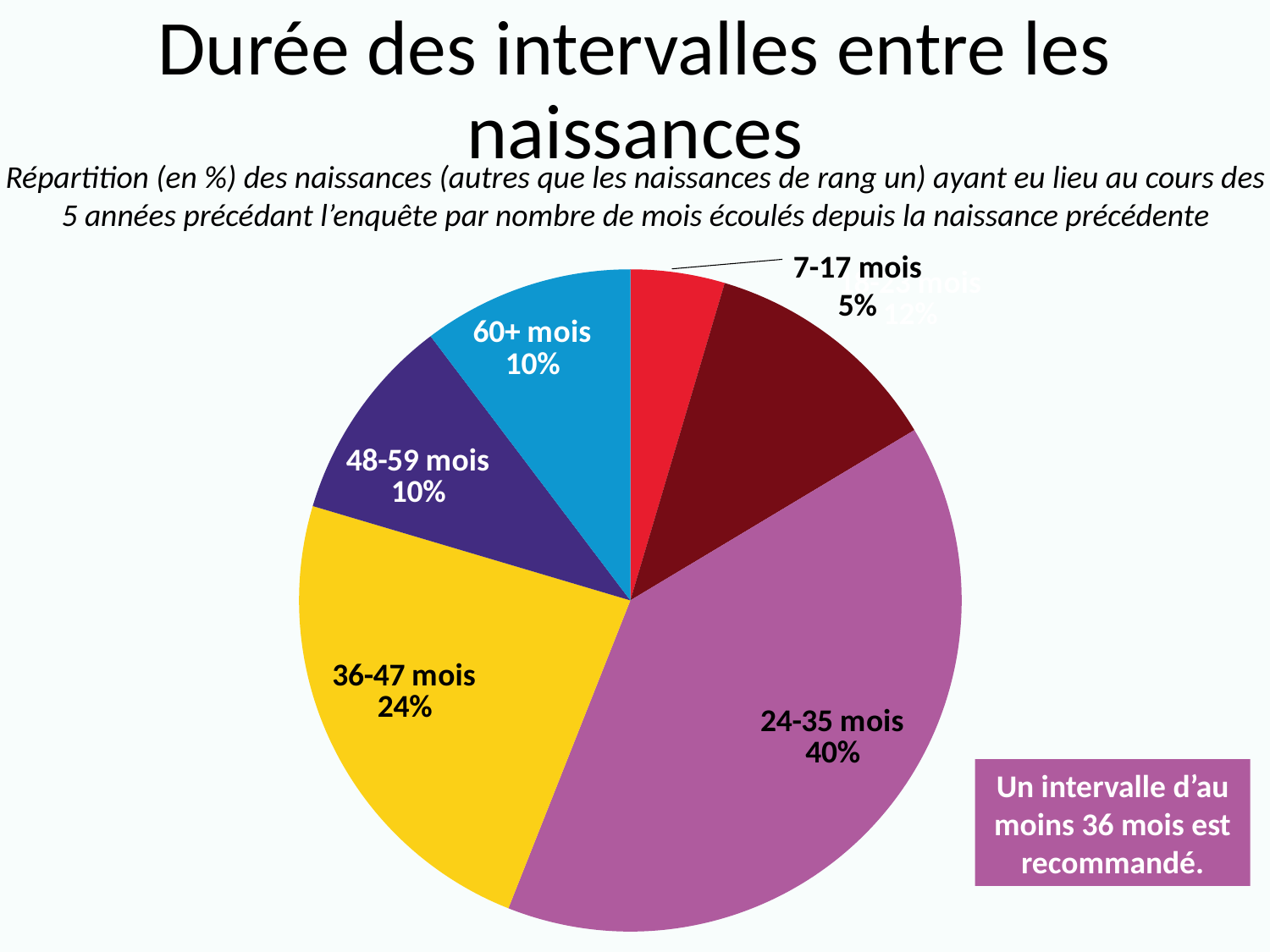
What does the text box at the bottom right of the slide say? Un intervalle d'au moins 36 mois est recommandé. What type of chart is shown on the slide? Pie chart Which interval category has the smallest share of the pie? 7-17 mois Which interval category has the largest share of the pie? 24-35 mois What share of births had an interval of 24-35 mois? 40% What is the difference in percentage points between the 24-35 mois slice and the 36-47 mois slice? 16 What share is shown for the 60+ mois category? 10% Which slice is larger, 36-47 mois or 48-59 mois? 36-47 mois How many slices does the pie chart have? 6 What percentage is shown for the 7-17 mois slice? 5% What percentage is shown for the 36-47 mois slice? 24% What is the title of the slide? Durée des intervalles entre les naissances